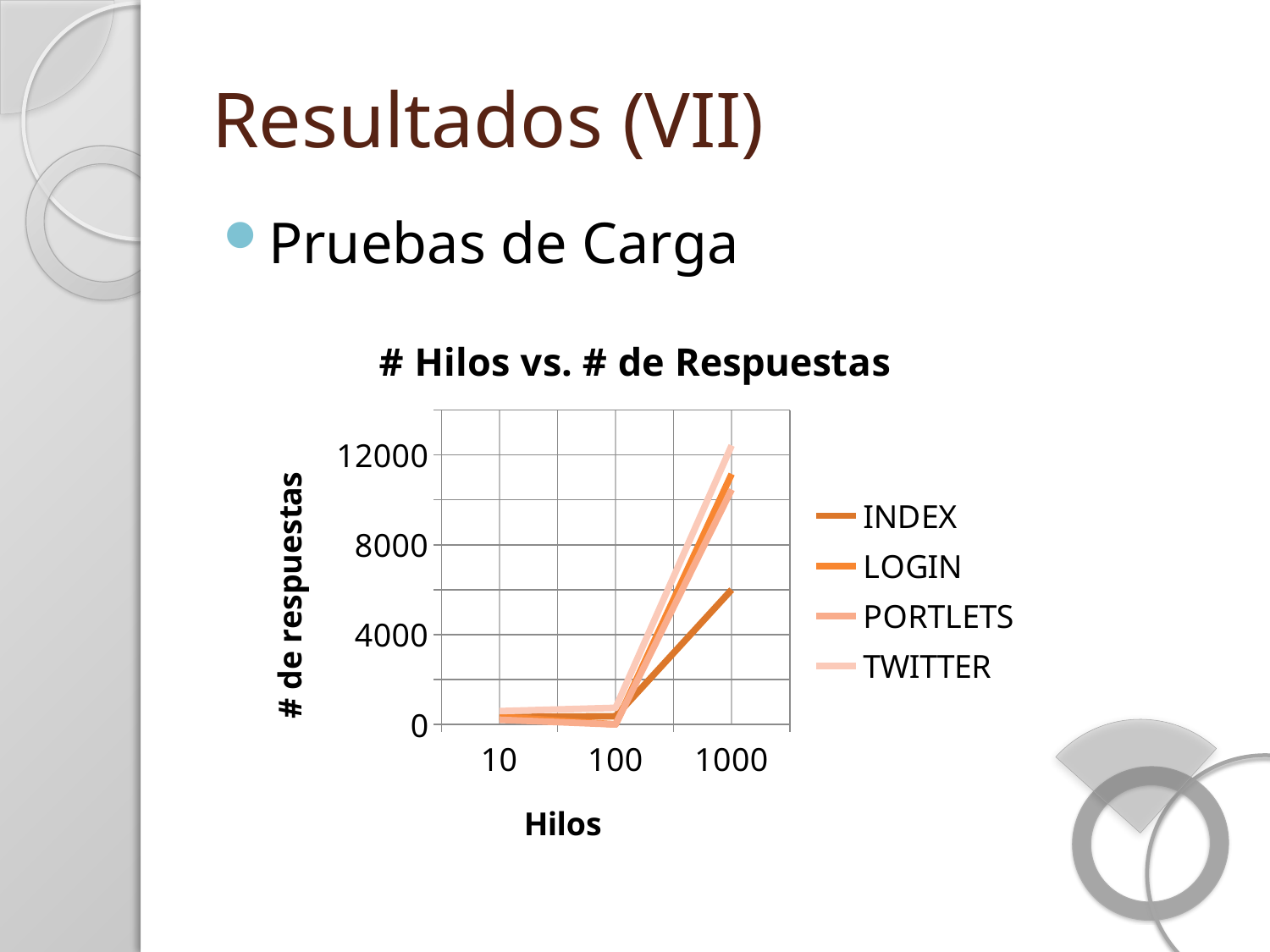
What is the label of the y axis? # de respuestas What is the title of the chart? # Hilos vs. # de Respuestas Is the value for PORTLETS at 100 hilos greater or less than 4000? less Is the value for INDEX at 1000 hilos greater or less than 8000? less Is the value for LOGIN at 1000 hilos greater or less than 8000? greater Does the INDEX series rise or fall from 100 to 1000 hilos? rise What kind of chart is shown on the slide? line chart Which series has the lowest number of responses at 1000 hilos? INDEX How many series does the legend list? 4 Which is larger at 1000 hilos, INDEX or TWITTER? TWITTER How many values are shown on the x axis (Hilos)? 3 Which series has the highest number of responses at 1000 hilos? TWITTER